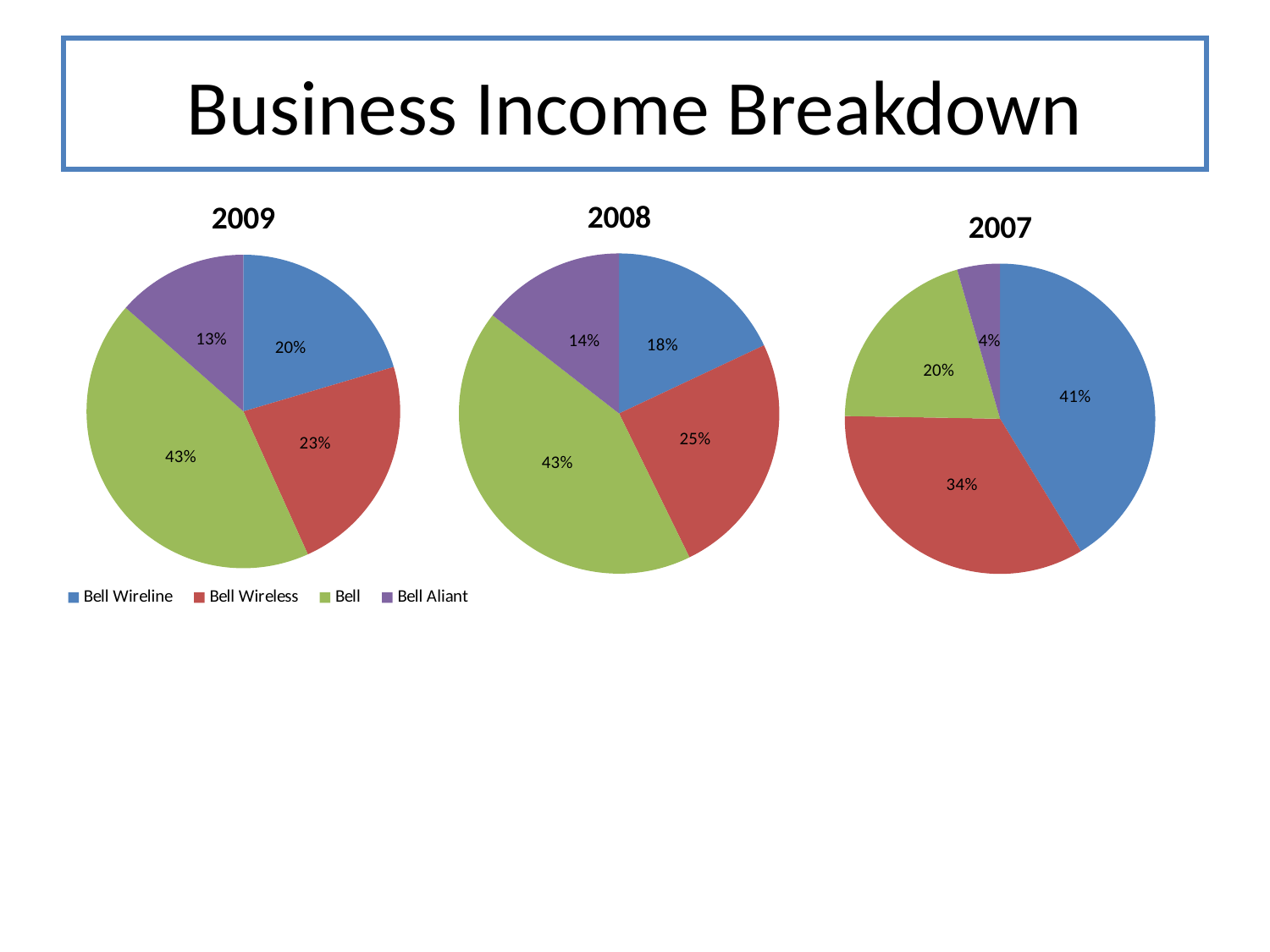
In the 2007 pie chart, what share does Bell Aliant have? 4% In the 2007 pie chart, what is the difference between the Bell Wireline share and the Bell Wireless share? 7% In the 2007 pie chart, which category has the largest share? Bell Wireline How many entries does the legend list? 4 In the 2008 pie chart, what share does Bell Wireless have? 25% How many slices does the 2008 pie chart have? 4 Which colour represents Bell Aliant in the legend? Purple In the 2008 pie chart, which category has the largest share? Bell In the 2009 pie chart, what share does Bell Wireline have? 20% In the 2009 pie chart, which category has the smallest share? Bell Aliant What kind of chart is the 2007 chart? Pie chart In the 2009 pie chart, which is larger: the Bell Wireless share or the Bell Wireline share? Bell Wireless